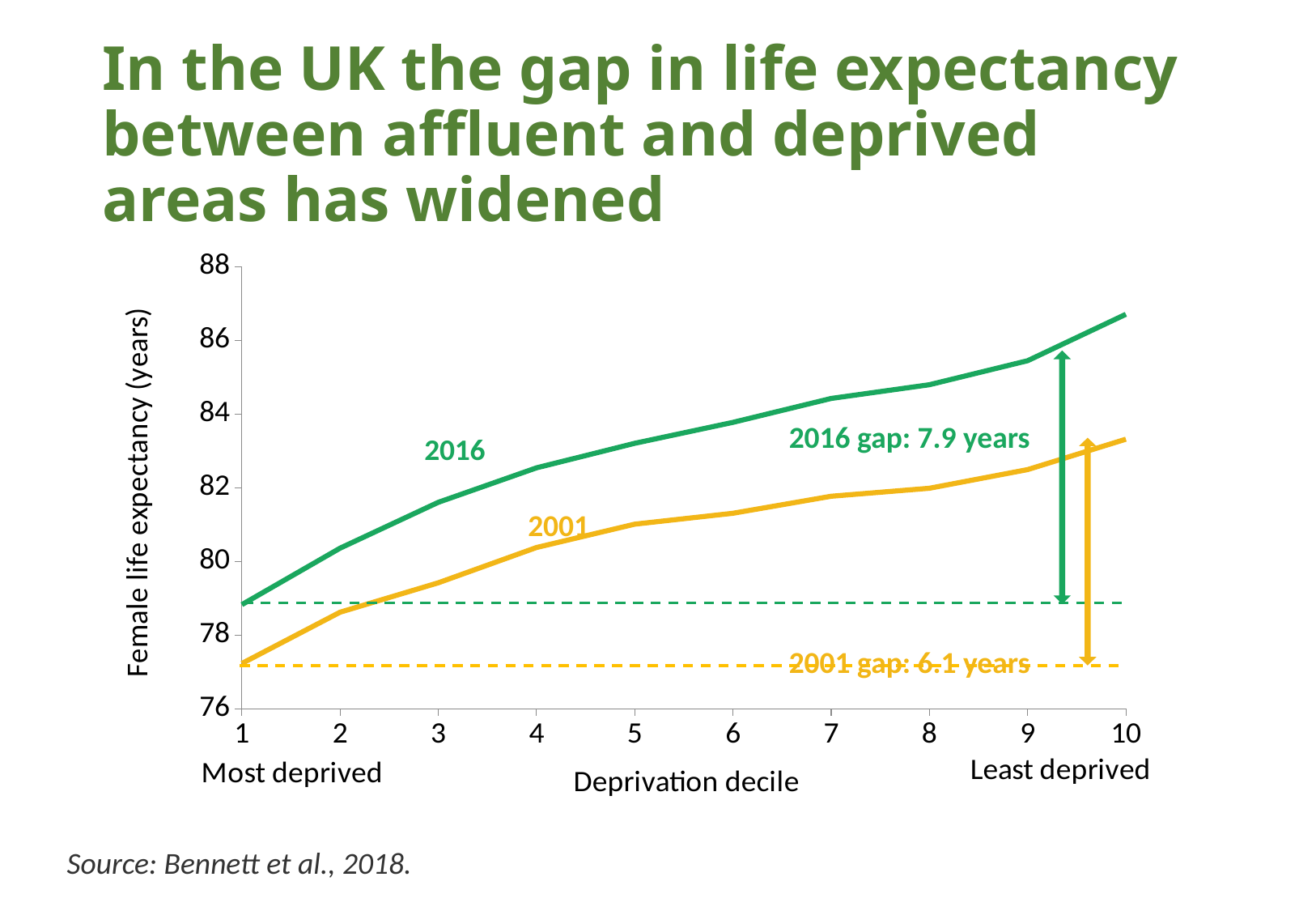
Is the 2016 female life expectancy at decile 10 greater or less than 86? greater How many deprivation deciles are shown along the x axis? 10 Do the female life expectancy values rise or fall as the deprivation decile increases from 1 to 10? Rise What kind of chart is shown on the slide? Line chart What is the 2016 gap in female life expectancy stated on the chart? 7.9 years At deprivation decile 5, which series has the higher female life expectancy, 2016 or 2001? 2016 What is the 2001 gap in female life expectancy stated on the chart? 6.1 years How many series are plotted on the chart? 2 By how many years is the 2016 gap larger than the 2001 gap? 1.8 years What is the label of the y axis? Female life expectancy (years) Which deprivation decile has the lowest female life expectancy in the 2001 series? 1 Which deprivation decile has the highest female life expectancy in the 2016 series? 10